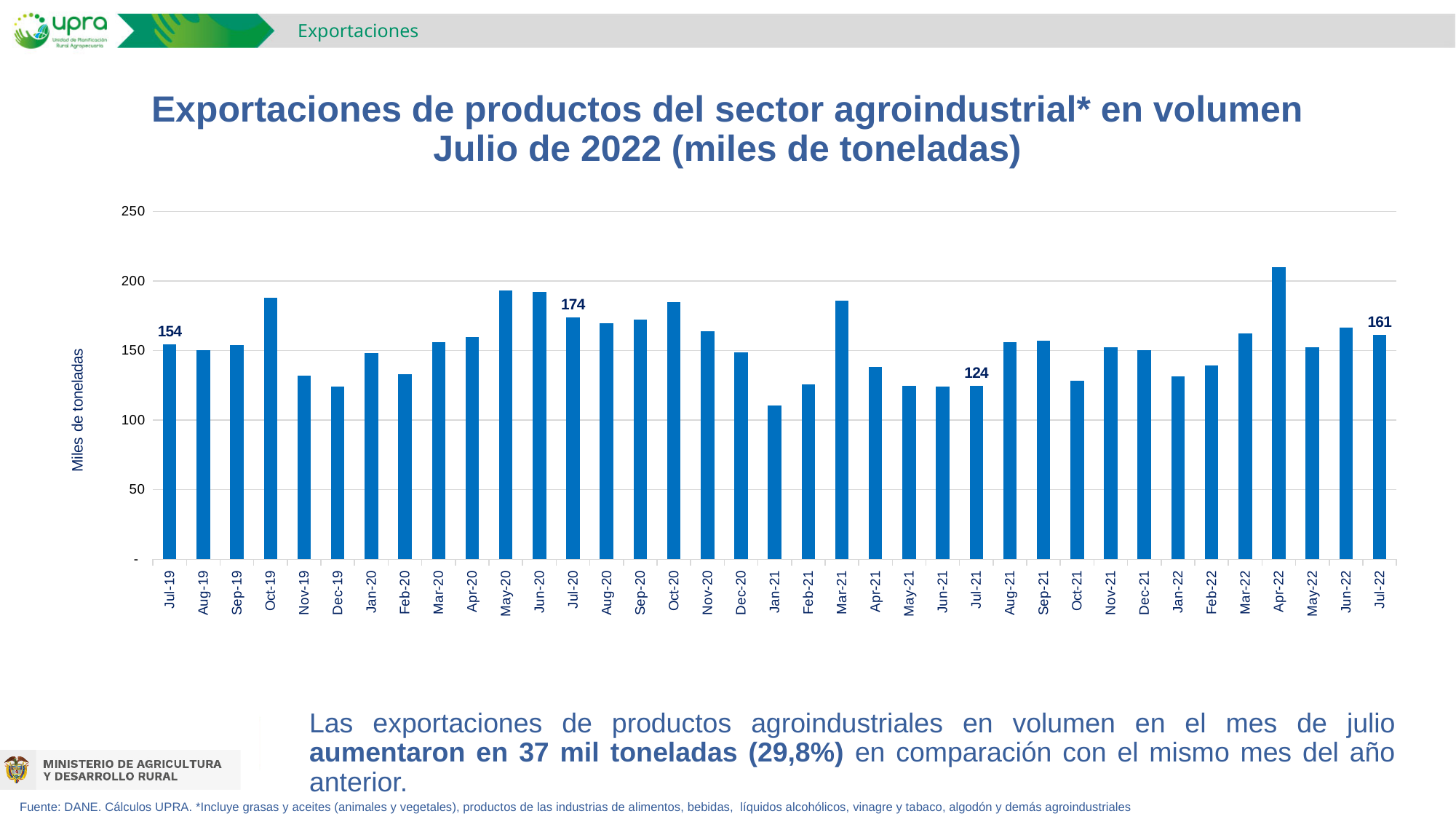
How many months are plotted on the chart? 37 What is the value for Jul-19? 154 What is the difference between the values for Jul-20 and Jul-19? 20 What is the value for Jul-22? 161 What is the difference between the values for Jul-22 and Jul-21? 37 Is the value for Dec-19 greater or less than 150? less Which month has the highest value? Apr-22 What is the value for Jul-21? 124 Which is larger, the value for Jul-20 or the value for Jul-22? Jul-20 Which month has the lowest value? Jan-21 Is the value for Apr-22 greater or less than 200? greater What kind of chart is shown on the slide? Bar chart